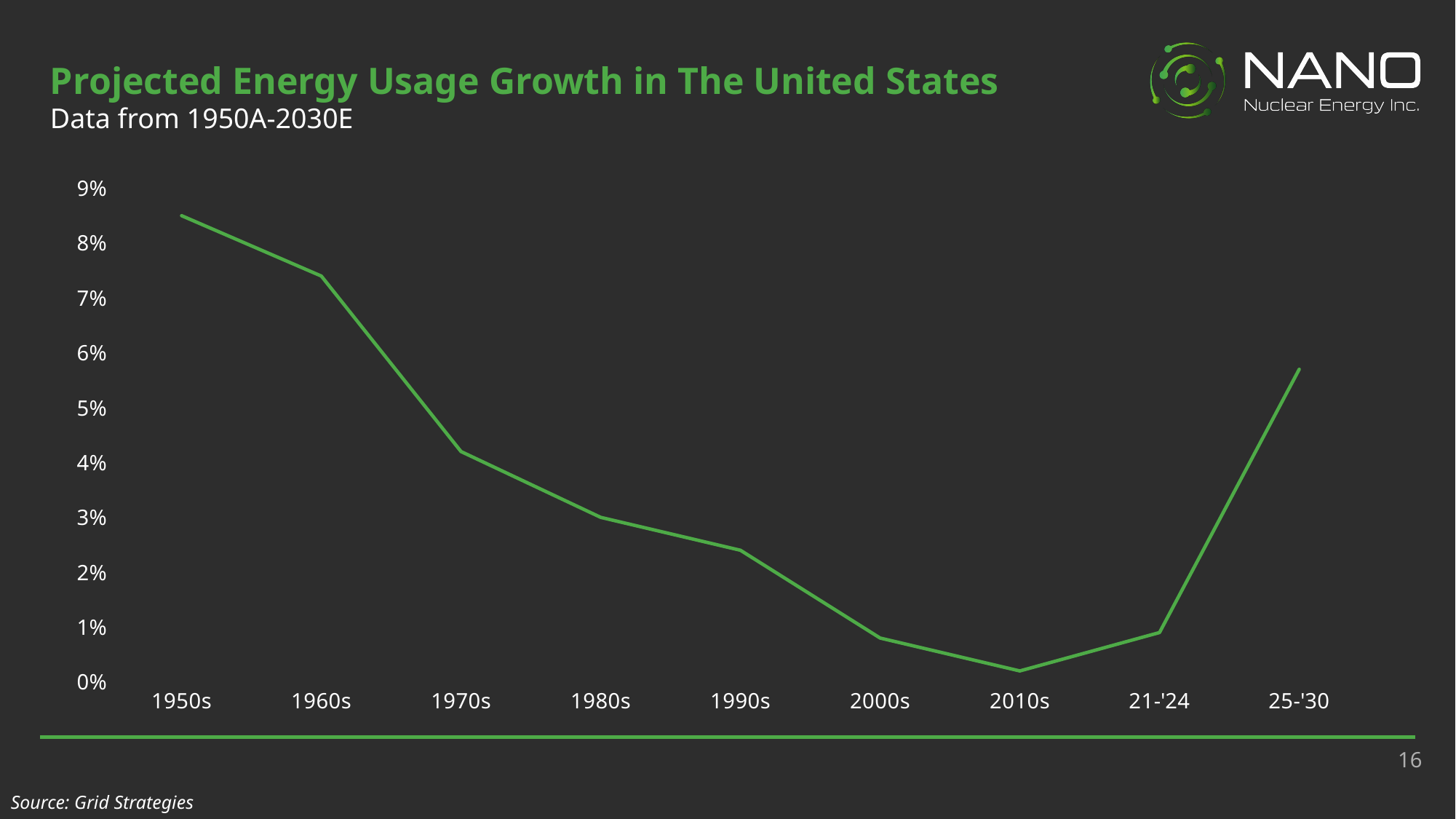
Is the value for the 1970s greater or less than 4%? greater What kind of chart is shown on the slide? line chart Which period has the lowest energy usage growth? 2010s Is the value for the 2010s greater or less than 1%? less Which period has the highest projected energy usage growth? 1950s Which is larger, the value for the 1970s or the value for the 1990s? 1970s Is the value for the 1950s greater or less than 8%? greater Do the values rise or fall from the 1950s to the 2010s? fall How many time periods are plotted along the x axis? 9 Which is larger, the value for the 1960s or the value for 25-'30? 1960s What is the source cited for the chart? Grid Strategies